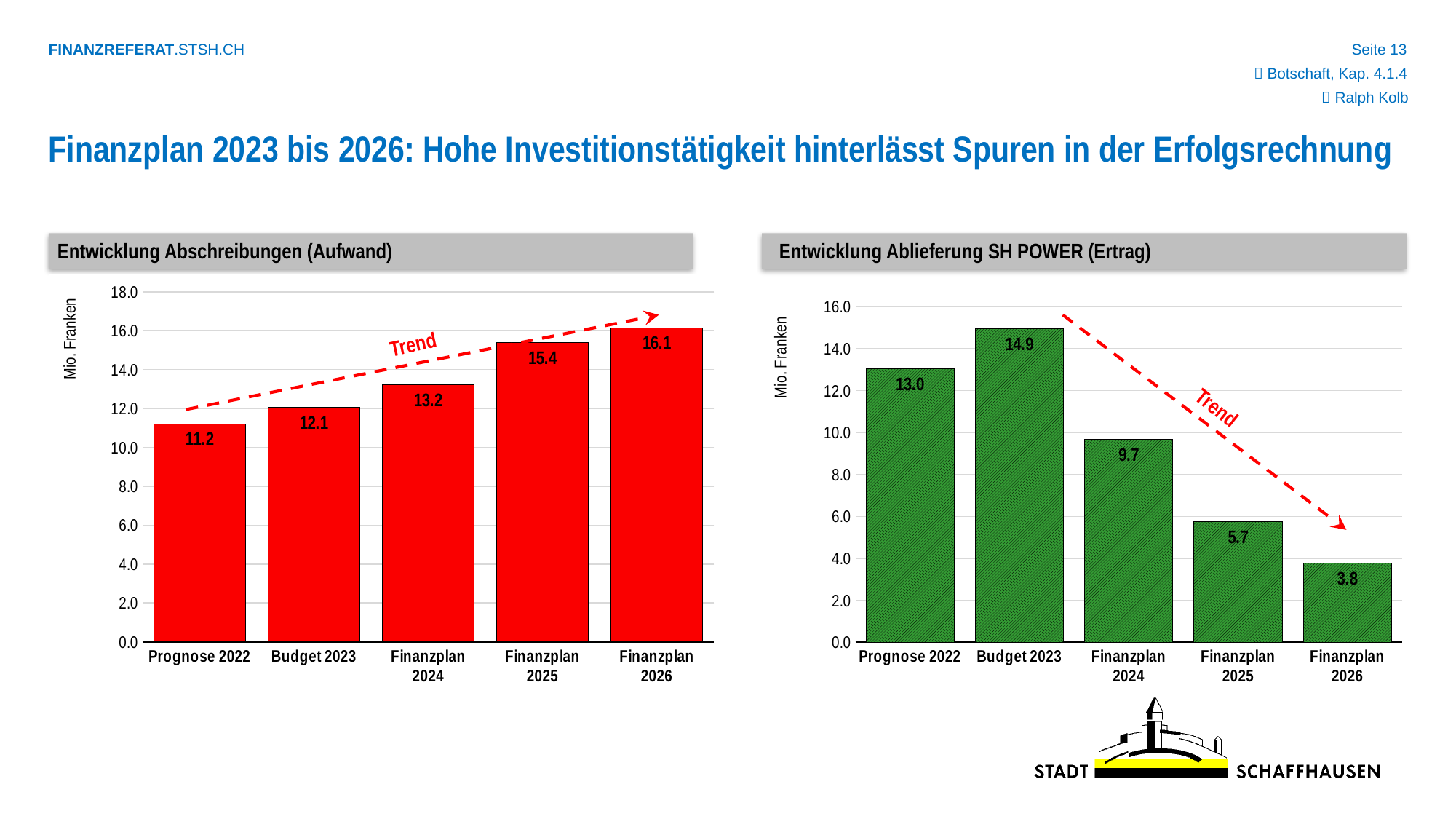
In the 'Entwicklung Abschreibungen (Aufwand)' chart, which is larger: Finanzplan 2024 or Finanzplan 2025? Finanzplan 2025 In the 'Entwicklung Abschreibungen (Aufwand)' chart, what is the difference between Finanzplan 2026 and Prognose 2022? 4.9 In the 'Entwicklung Abschreibungen (Aufwand)' chart, which category has the highest value? Finanzplan 2026 In the 'Entwicklung Ablieferung SH POWER (Ertrag)' chart, which category has the lowest value? Finanzplan 2026 In the 'Entwicklung Ablieferung SH POWER (Ertrag)' chart, what is the value for Finanzplan 2025? 5.7 In the 'Entwicklung Ablieferung SH POWER (Ertrag)' chart, which category has the highest value? Budget 2023 In the 'Entwicklung Ablieferung SH POWER (Ertrag)' chart, what is the difference between Budget 2023 and Finanzplan 2024? 5.2 In the 'Entwicklung Ablieferung SH POWER (Ertrag)' chart, is the value for Prognose 2022 greater or less than 12.0? greater How many categories are shown in the 'Entwicklung Abschreibungen (Aufwand)' chart? 5 In the 'Entwicklung Abschreibungen (Aufwand)' chart, what is the value for Budget 2023? 12.1 In the 'Entwicklung Ablieferung SH POWER (Ertrag)' chart, do the values rise or fall from Budget 2023 to Finanzplan 2026? fall What kind of chart is the 'Entwicklung Ablieferung SH POWER (Ertrag)' chart? bar chart